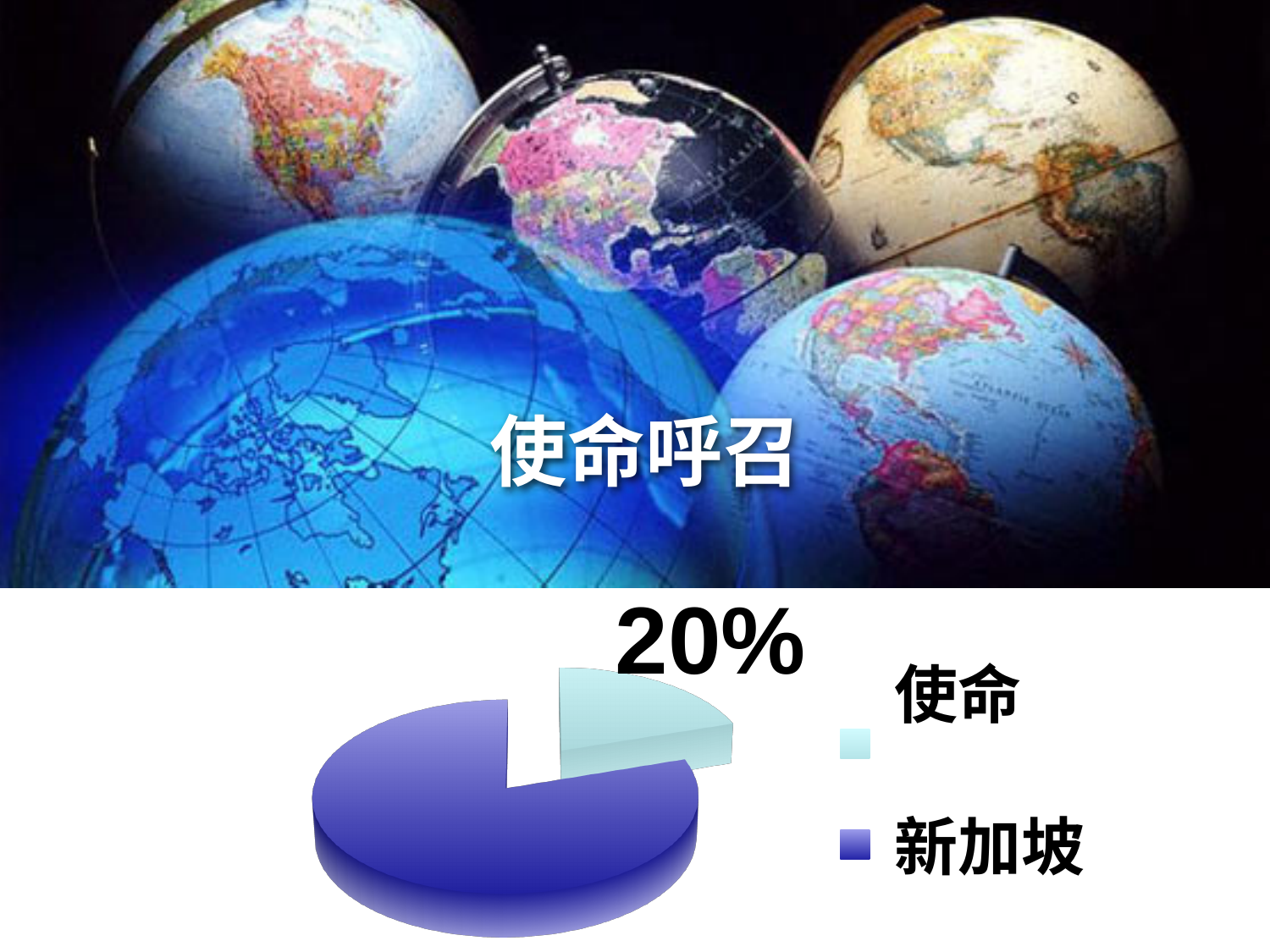
How many entries does the legend list? 2 Which slice is pulled out (exploded) from the pie chart? 使命 Which is larger in the pie chart, 新加坡 or 使命? 新加坡 Which slice of the pie chart is the largest? 新加坡 What kind of chart is shown on the slide? pie chart What percentage is shown for 使命 in the pie chart? 20% Which slice of the pie chart is the smallest? 使命 What colour is the 新加坡 slice in the pie chart? blue What share of the pie does the 使命 slice represent? 20% How many slices does the pie chart have? 2